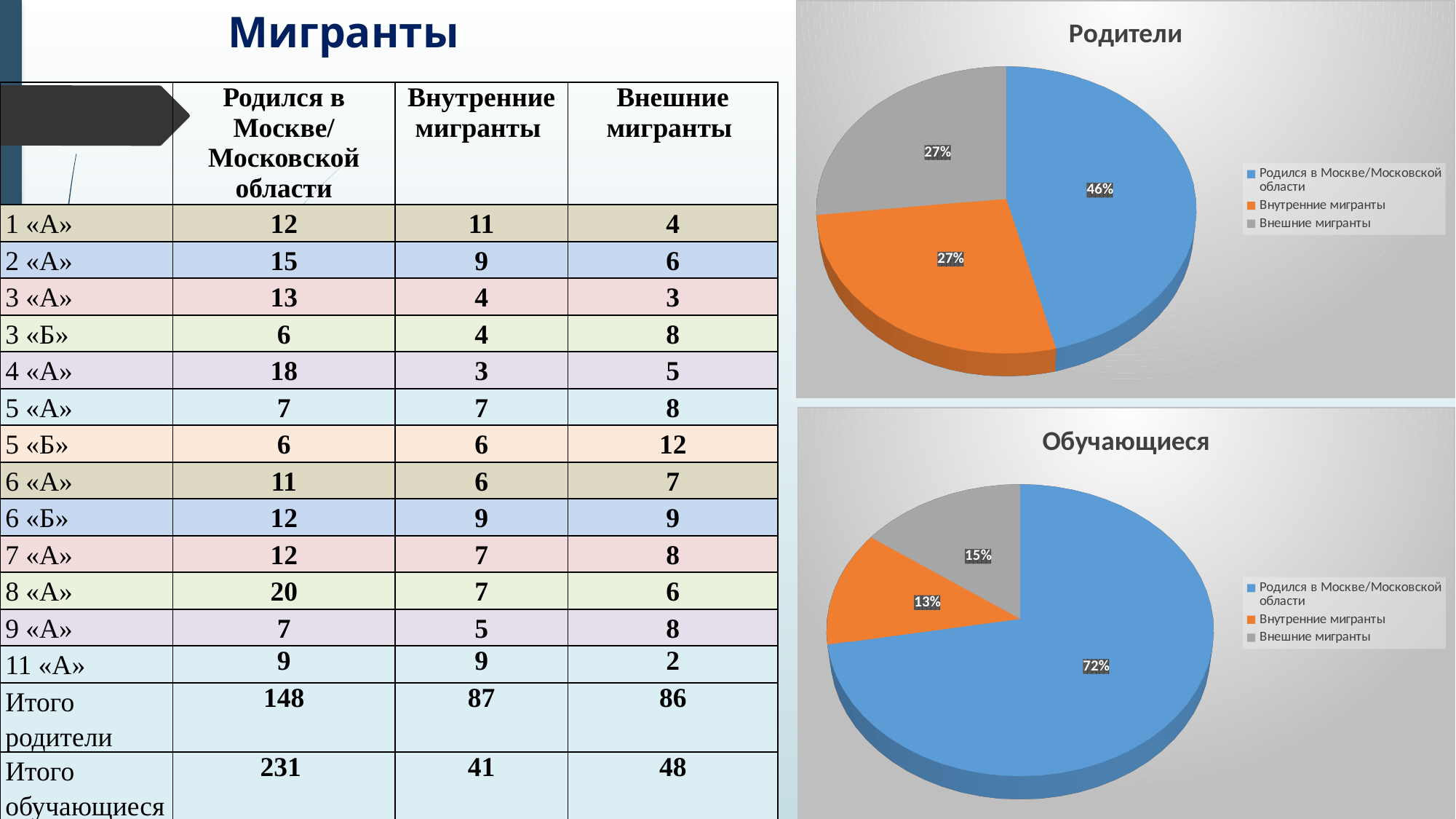
In the "Родители" chart, what share is shown for "Внутренние мигранты"? 27% In the "Родители" chart, what colour is the "Внутренние мигранты" slice? Orange How many slices does the "Обучающиеся" chart have? 3 In the "Обучающиеся" chart, what share is shown for "Внешние мигранты"? 15% In the "Родители" chart, what share is shown for "Родился в Москве/Московской области"? 46% In the "Обучающиеся" chart, which is larger: "Внутренние мигранты" or "Внешние мигранты"? Внешние мигранты What is the difference between the "Родился в Москве/Московской области" share in the "Обучающиеся" chart and in the "Родители" chart? 26% What type of chart is the "Родители" chart? Pie chart In the "Обучающиеся" chart, which category has the smallest slice? Внутренние мигранты In the "Родители" chart, which category has the largest slice? Родился в Москве/Московской области